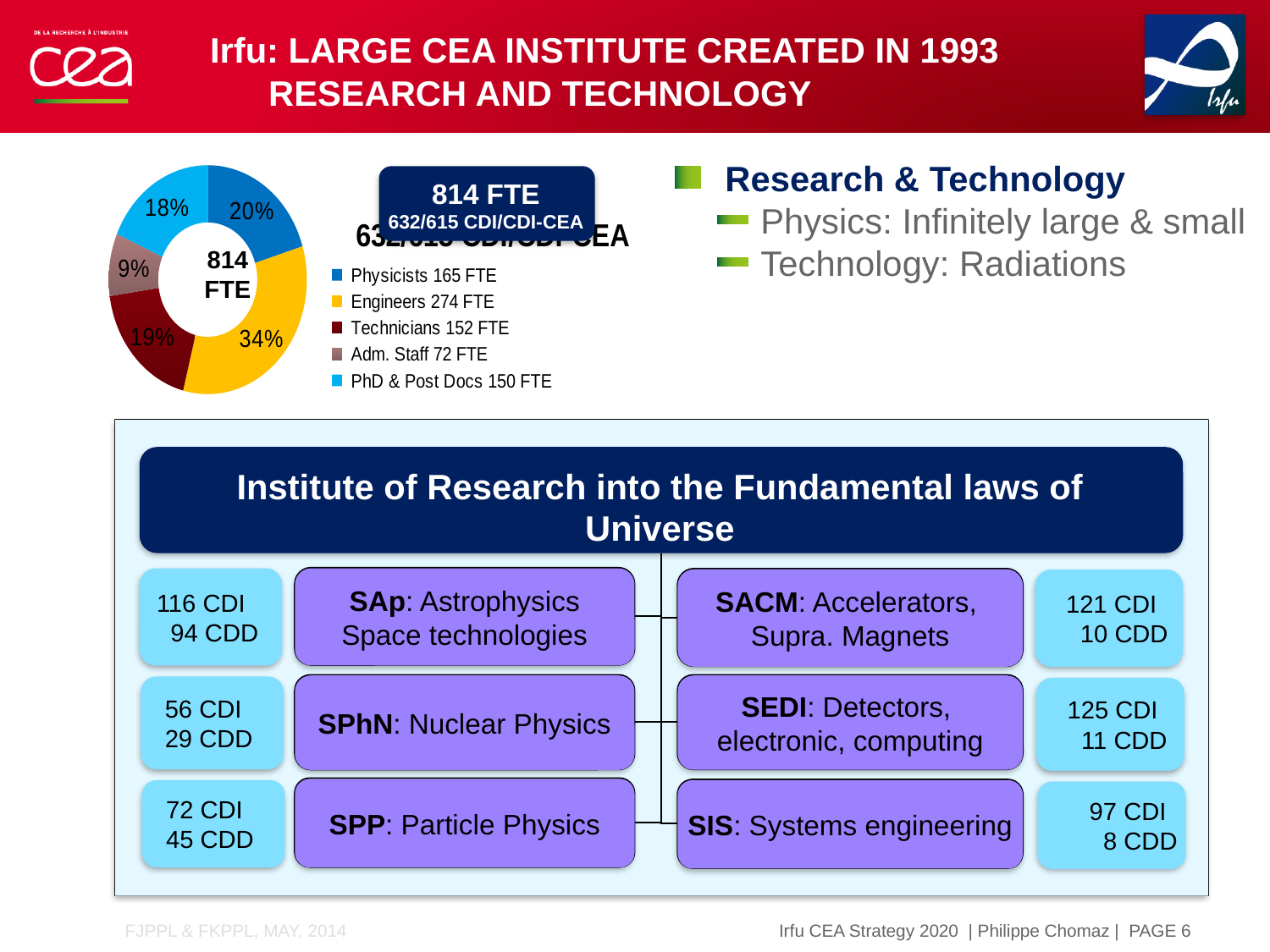
What is the FTE value for Engineers in the doughnut chart? 274 FTE Which category has the smallest share in the doughnut chart? Adm. Staff How many categories does the doughnut chart's legend list? 5 What share of the doughnut chart do Engineers represent? 34% Which category has the largest share in the doughnut chart? Engineers What colour is the Engineers slice in the doughnut chart? yellow What share of the doughnut chart does Adm. Staff represent? 9% What is the FTE value for Technicians in the doughnut chart? 152 FTE Which is larger in the doughnut chart, Physicists or PhD & Post Docs? Physicists What is the difference in FTE between Engineers and Physicists in the doughnut chart? 109 FTE What kind of chart is shown on the slide? doughnut (pie) chart What total FTE is shown in the centre of the doughnut chart? 814 FTE